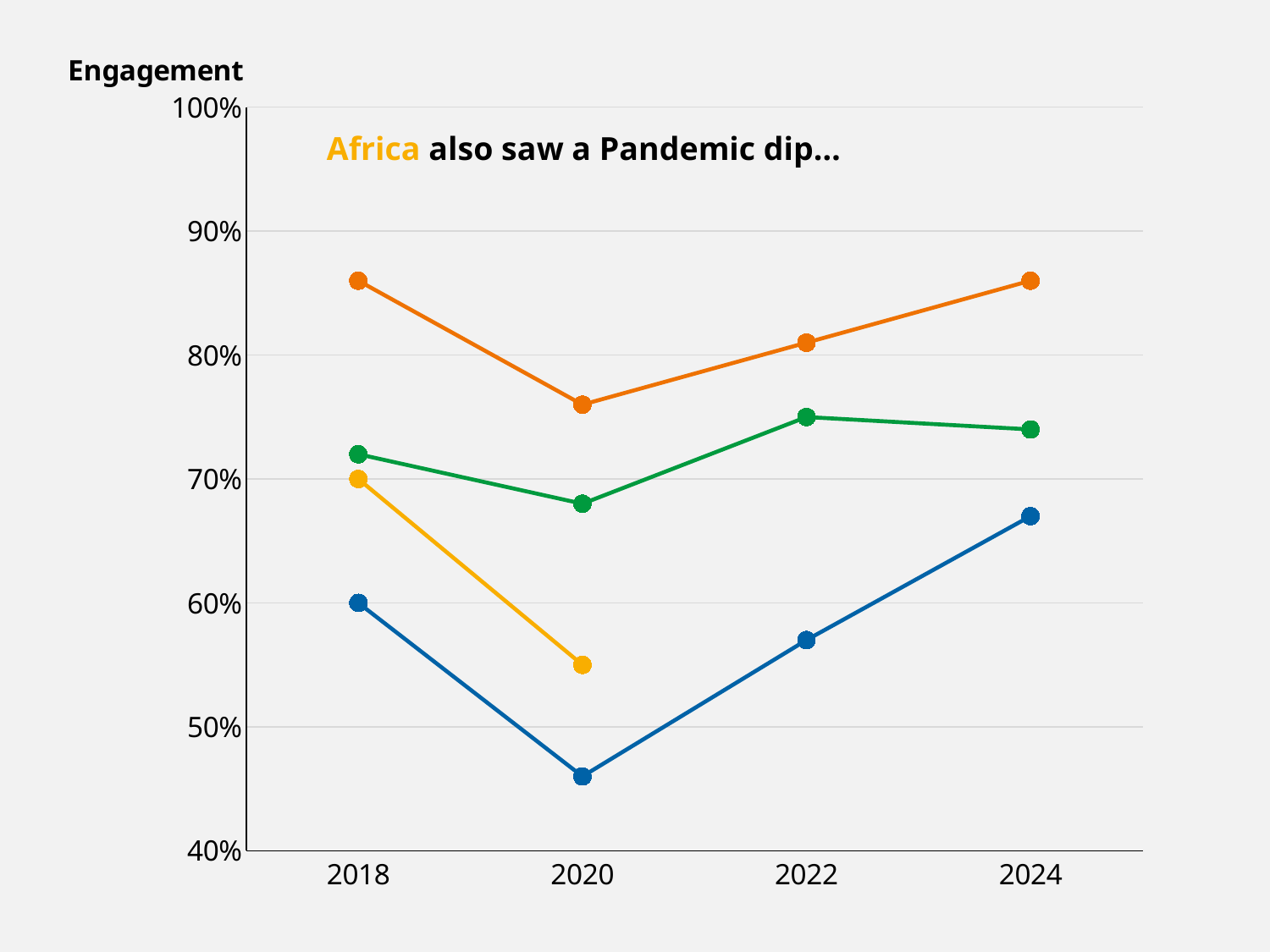
Does the blue line rise or fall from 2020 to 2024? rise In which year is the Africa line at its highest? 2018 Is the engagement value for Africa in 2020 greater or less than 60%? less Does the Africa line rise or fall from 2018 to 2020? fall In 2020, which line has the higher value, the orange line or the green line? the orange line What is the engagement value for Africa in 2018? 70% How many years are shown on the x axis? 4 Is the value of the blue line in 2020 greater or less than 50%? less Is the value of the orange line in 2024 greater or less than 80%? greater What is the label on the y axis of the chart? Engagement What is the value of the blue line in 2018? 60% What kind of chart is shown on the slide? line chart